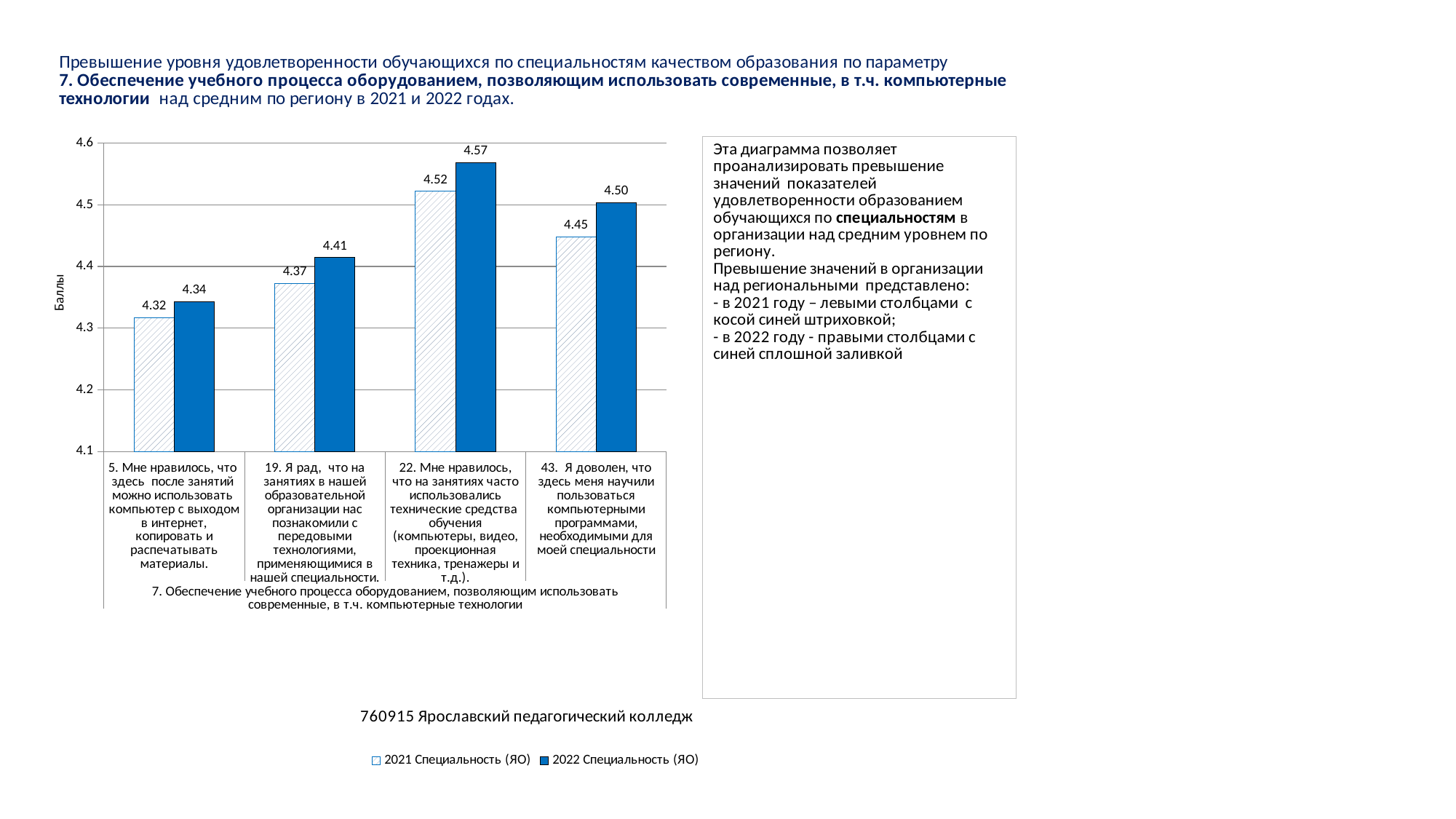
How many series does the chart legend list? 2 Which statement has the lowest 2021 Специальность (ЯО) value? 5. Мне нравилось, что здесь после занятий можно использовать компьютер с выходом в интернет Which is larger for statement 43: the 2021 Специальность (ЯО) value or the 2022 Специальность (ЯО) value? 2022 Специальность (ЯО) What is the 2022 Специальность (ЯО) value for statement 22 ("Мне нравилось, что на занятиях часто использовались технические средства обучения")? 4.57 What is the label of the vertical axis of the chart? Баллы Which statement has the highest 2022 Специальность (ЯО) value? 22. Мне нравилось, что на занятиях часто использовались технические средства обучения How many categories (statements) are shown on the x axis of the chart? 4 Is the 2022 Специальность (ЯО) value for statement 5 greater or less than 4.4? less What is the 2021 Специальность (ЯО) value for statement 43 ("Я доволен, что здесь меня научили пользоваться компьютерными программами")? 4.45 What is the 2021 Специальность (ЯО) value for statement 5 ("Мне нравилось, что здесь после занятий можно использовать компьютер с выходом в интернет")? 4.32 What is the difference between the 2022 and 2021 values for statement 19 ("Я рад, что на занятиях в нашей образовательной организации нас познакомили с передовыми технологиями")? 0.04 What type of chart is shown on the slide? bar chart